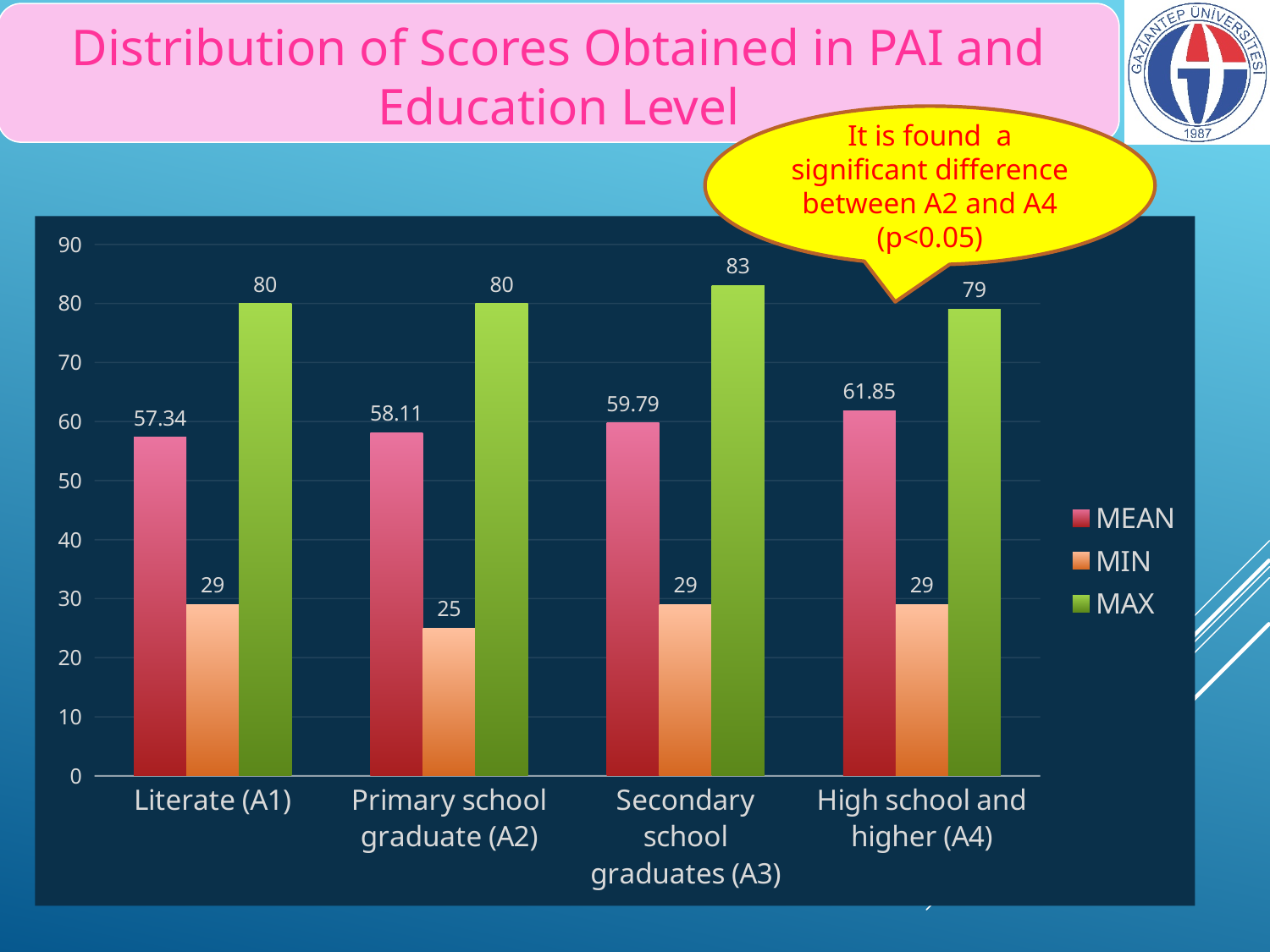
What is the MEAN value for Literate (A1)? 57.34 What is the MEAN value for High school and higher (A4)? 61.85 Which education level has the lowest MIN value? Primary school graduate (A2) What kind of chart is shown on the slide? Bar chart Which is larger, the MAX value for Secondary school graduates (A3) or the MAX value for High school and higher (A4)? Secondary school graduates (A3) Which education level has the highest MEAN value? High school and higher (A4) How many series does the legend list? 3 Do the MEAN values rise or fall from Literate (A1) to High school and higher (A4)? Rise What is the MAX value for Secondary school graduates (A3)? 83 How many education level categories are shown on the x axis? 4 What is the difference between the MEAN values for High school and higher (A4) and Primary school graduate (A2)? 3.74 What is the MIN value for Primary school graduate (A2)? 25